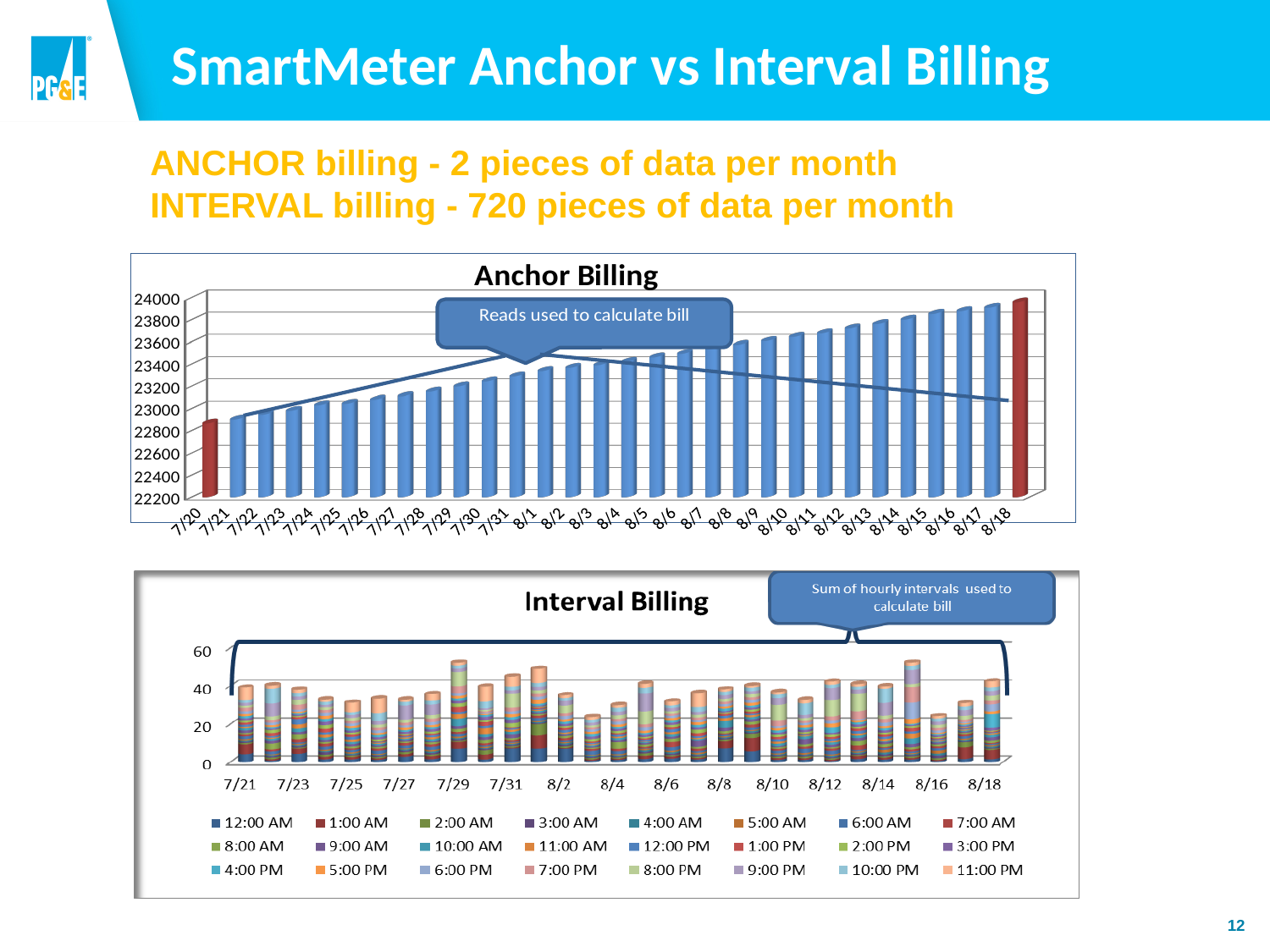
In the Anchor Billing chart, which date has the highest value? 8/18 In the Interval Billing chart, is the total for 8/3 greater or less than 30? less In the Anchor Billing chart, how many dates are shown on the x axis? 30 In the Anchor Billing chart, is the value for 7/20 greater or less than 23000? less In the Anchor Billing chart, do the values rise or fall from 7/20 to 8/18? Rise In the Interval Billing chart, is the total for 7/29 greater or less than 40? greater What kind of chart is the Anchor Billing chart? Bar chart How many series does the legend of the Interval Billing chart list? 24 In the Anchor Billing chart, which is larger, the value for 8/10 or the value for 7/25? 8/10 In the Anchor Billing chart, which two bars are coloured red instead of blue? 7/20 and 8/18 In the Anchor Billing chart, which date has the lowest value? 7/20